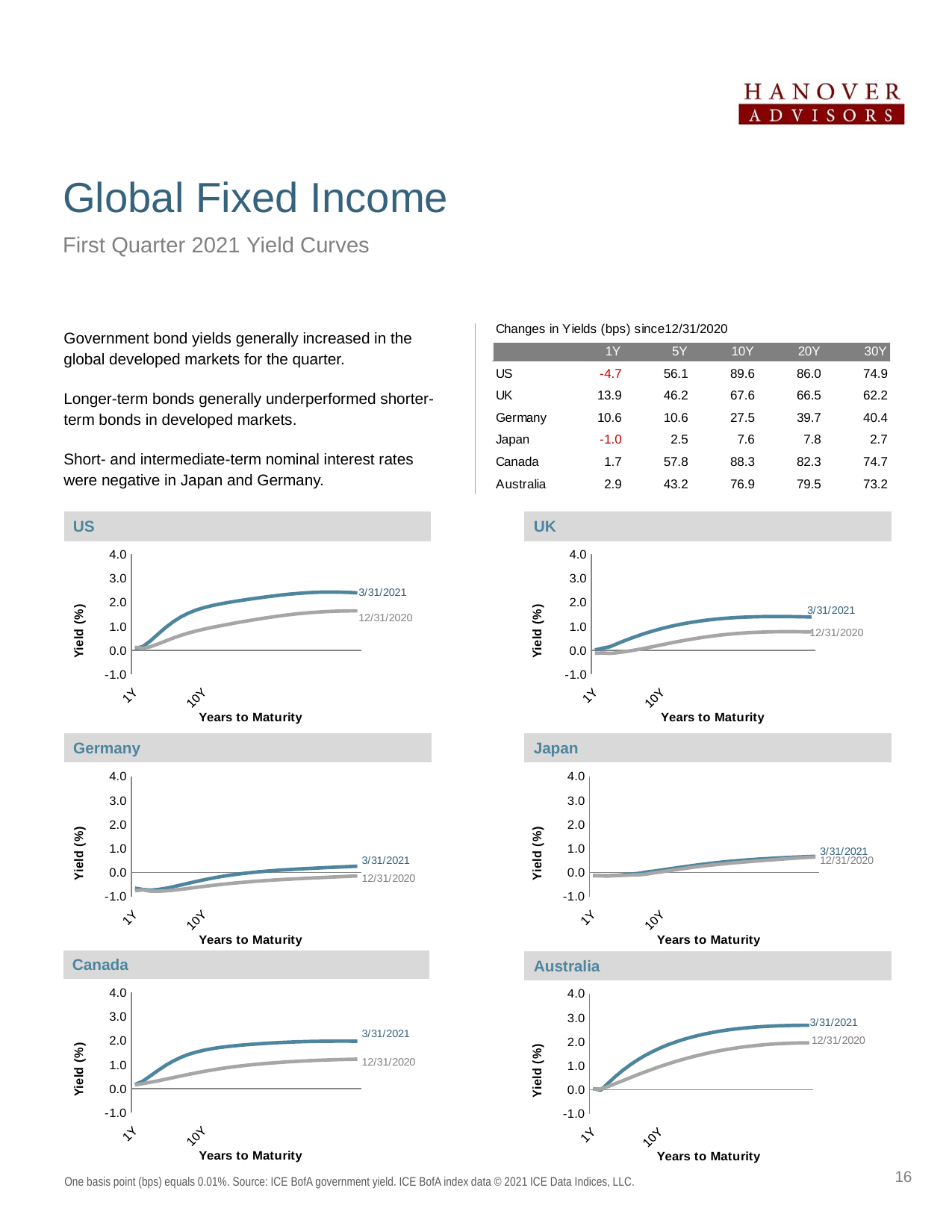
What kind of chart is the US chart? line chart In the Japan chart, is the 12/31/2020 yield at the longest maturity shown greater or less than 1.0? less How many series does the US chart show? 2 In the US chart, does the 3/31/2021 yield rise or fall as years to maturity increase? rise In the US chart, is the 3/31/2021 yield at the longest maturity shown greater or less than 2.0? greater In the Canada chart, is the 12/31/2020 yield at the longest maturity shown greater or less than 1.0? greater How many yield curve charts are on the slide? 6 What is the y-axis label of the Germany chart? Yield (%) What is the x-axis title of the Canada chart? Years to Maturity In the UK chart, which series is higher at the longest maturity shown, 3/31/2021 or 12/31/2020? 3/31/2021